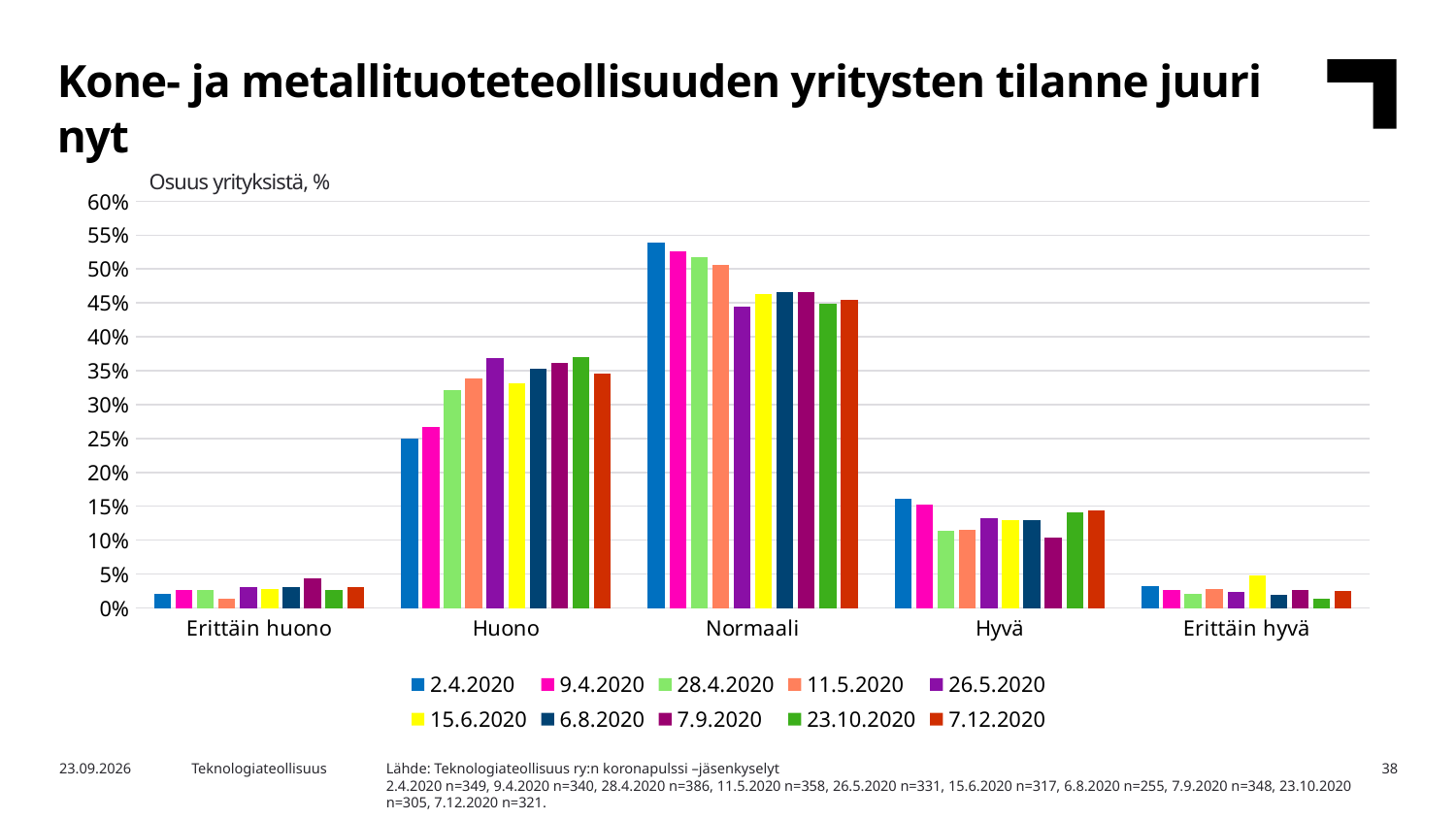
Is the value for 2.4.2020 in the Normaali category greater or less than 50%? greater What is the label shown above the y axis of the chart? Osuus yrityksistä, % Is the value for 2.4.2020 in the Huono category greater or less than 30%? less In the Erittäin hyvä category, which date has the highest value? 15.6.2020 In the Normaali category, which is larger: the value for 2.4.2020 or the value for 7.12.2020? 2.4.2020 How many series does the chart legend list? 10 In the Huono category, which is larger: the value for 2.4.2020 or the value for 7.12.2020? 7.12.2020 What kind of chart is shown on the slide? bar chart Which category has the tallest bars in the chart? Normaali How many categories are shown on the x axis of the chart? 5 Is the value for 7.9.2020 in the Hyvä category greater or less than 15%? less In the Huono category, do the values for the later survey dates generally rise or fall compared with 2.4.2020? rise